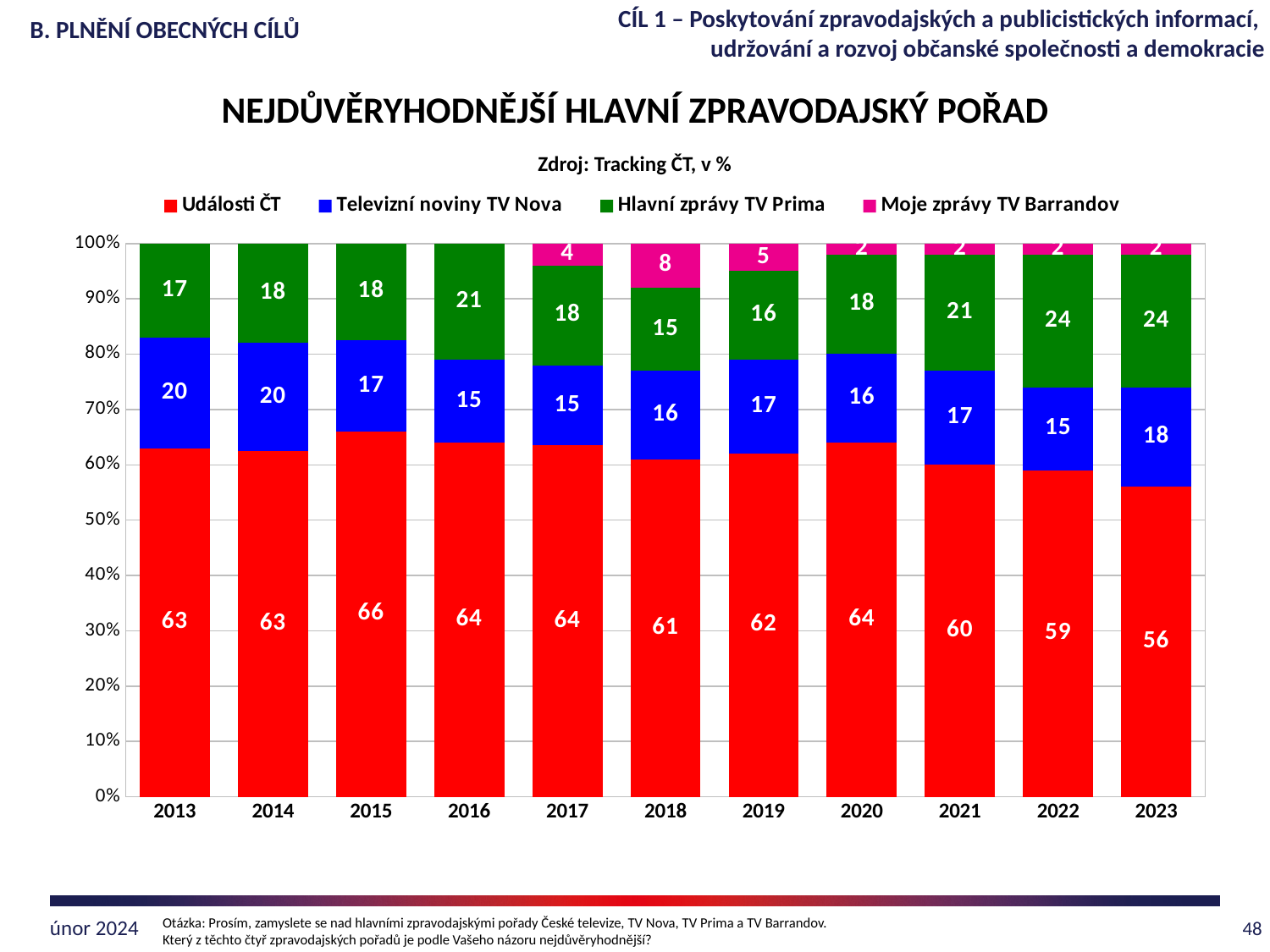
How many years are shown on the x axis? 11 In which year is the value for Události ČT the highest? 2015 What kind of chart is shown on the slide? Stacked bar chart In which year is the value for Události ČT the lowest? 2023 What is the value for Události ČT in 2015? 66 How many series does the legend list? 4 What is the difference between the Události ČT values in 2013 and 2023? 7 What is the value for Moje zprávy TV Barrandov in 2018? 8 In which year is the value for Moje zprávy TV Barrandov the highest? 2018 In 2023, which is larger: Televizní noviny TV Nova or Hlavní zprávy TV Prima? Hlavní zprávy TV Prima What is the value for Hlavní zprávy TV Prima in 2022? 24 Does the value for Události ČT rise or fall from 2020 to 2023? Fall